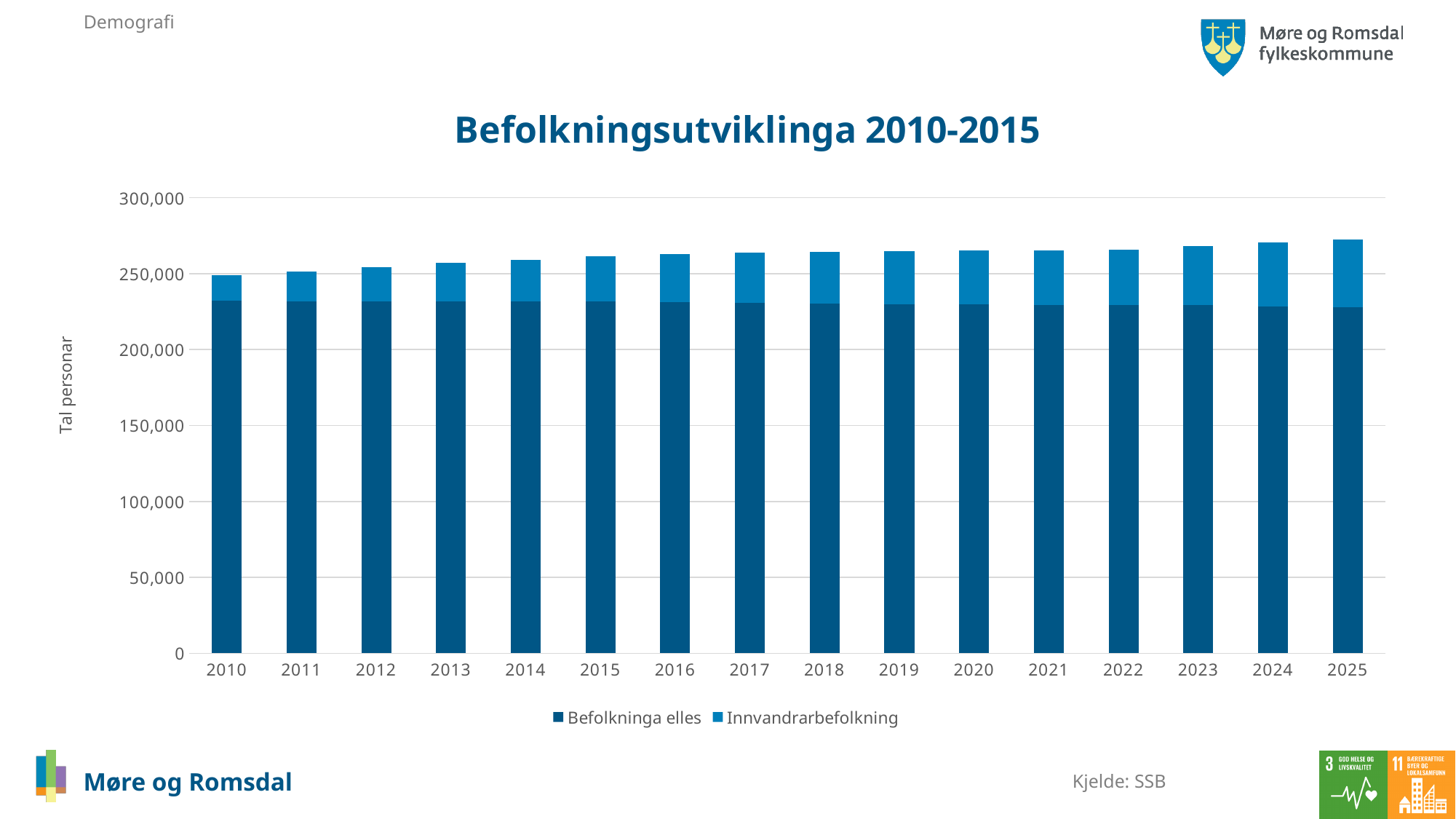
Which year has the lowest total bar in the chart? 2010 Is the Befolkninga elles value for 2010 greater or less than 200,000? greater How many series does the chart's legend list? 2 Is the total bar for 2025 greater or less than 250,000? greater Which year has the larger Innvandrarbefolkning segment, 2010 or 2025? 2025 What kind of chart is shown on the slide? Stacked bar chart Is the total bar for 2010 greater or less than 300,000? less How many years are shown along the x axis of the chart? 16 What is the title of the chart? Befolkningsutviklinga 2010-2015 Which year has the highest total bar in the chart? 2025 Do the total bar heights rise or fall from 2010 to 2025? Rise What is the label on the chart's y axis? Tal personar